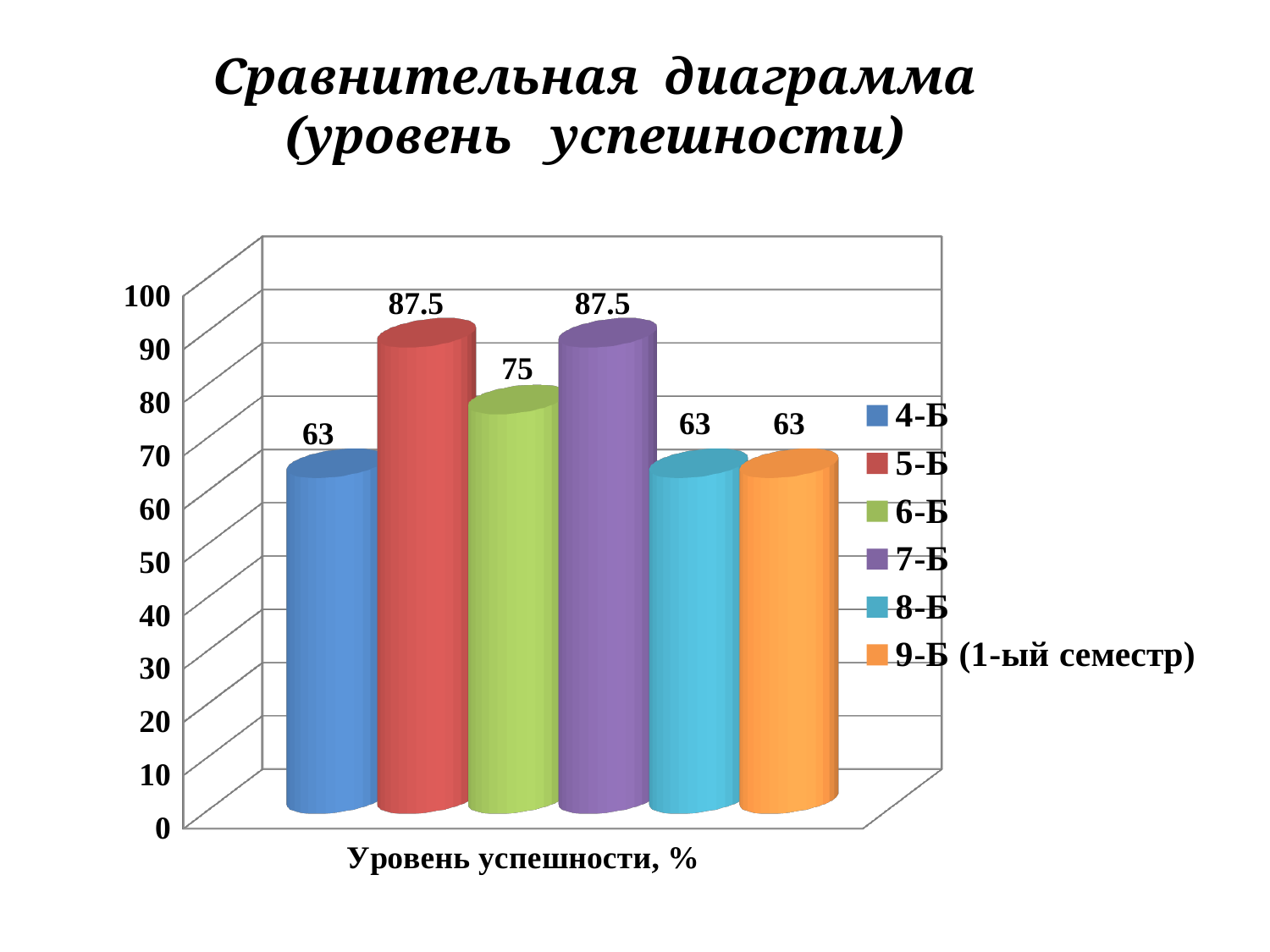
Is the value for 7-Б greater or less than 80? greater Which series has the lowest value among 5-Б, 6-Б and 7-Б? 6-Б Which is larger, the value for 6-Б or the value for 8-Б? 6-Б What is the value for 9-Б (1-ый семестр)? 63 What is the difference between the values for 7-Б and 8-Б? 24.5 What is the difference between the values for 5-Б and 6-Б? 12.5 What kind of chart is shown on the slide? bar chart What is the value for 5-Б? 87.5 How many series does the legend list? 6 What is the value for 4-Б? 63 What is the label on the horizontal axis of the chart? Уровень успешности, % What is the value for 6-Б? 75